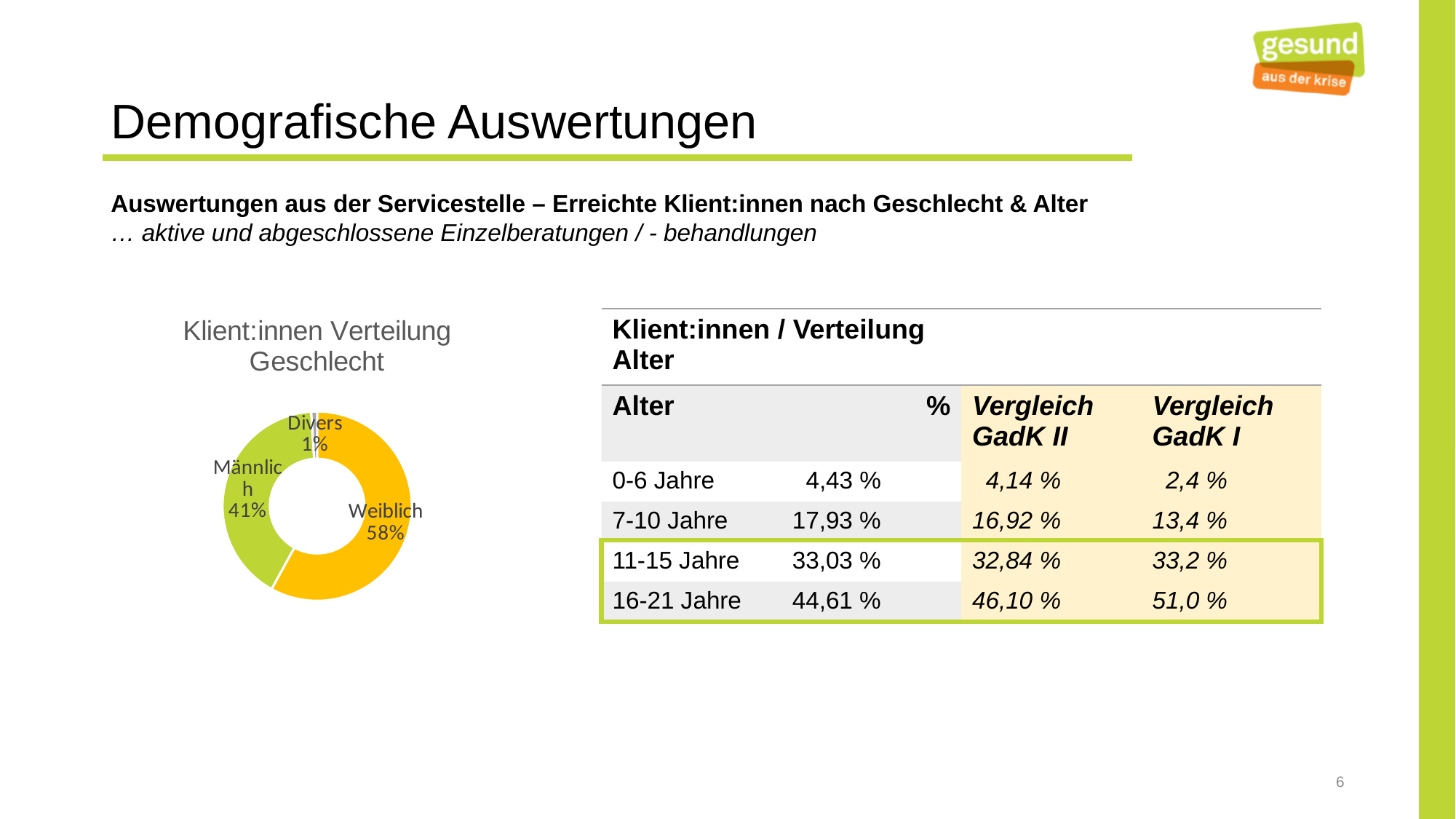
What is the share for Männlich in the "Klient:innen Verteilung Geschlecht" chart? 41% What is the title of the doughnut chart on the slide? Klient:innen Verteilung Geschlecht Which category has the largest share in the "Klient:innen Verteilung Geschlecht" chart? Weiblich What is the share for Weiblich in the "Klient:innen Verteilung Geschlecht" chart? 58% What is the share for Divers in the "Klient:innen Verteilung Geschlecht" chart? 1% In the "Klient:innen Verteilung Geschlecht" chart, which is larger: Männlich or Divers? Männlich How many categories are shown in the "Klient:innen Verteilung Geschlecht" chart? 3 In the "Klient:innen Verteilung Geschlecht" chart, how many percentage points larger is Weiblich than Männlich? 17 What kind of chart is "Klient:innen Verteilung Geschlecht"? Doughnut chart Which category has the smallest share in the "Klient:innen Verteilung Geschlecht" chart? Divers What colour is the Weiblich segment in the "Klient:innen Verteilung Geschlecht" chart? Orange